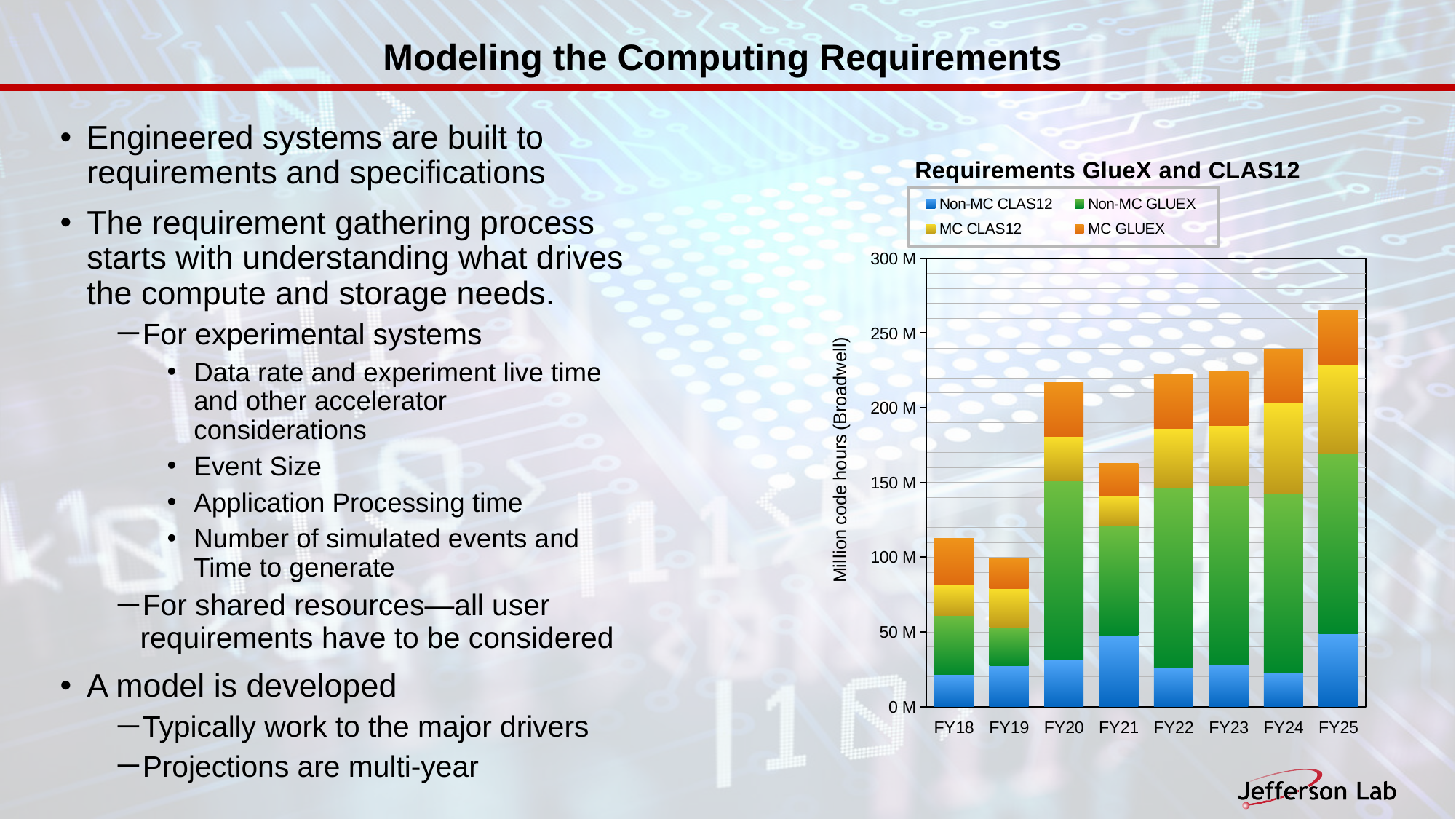
What is the label of the vertical axis of the chart? Million code hours (Broadwell) Is the total for FY21 greater or less than 150 M? greater Which fiscal year has the lowest total stacked bar? FY19 How many series does the chart legend list? 4 Is the total for FY25 greater or less than 250 M? greater What is the title of the chart? Requirements GlueX and CLAS12 Is the total for FY24 greater or less than 250 M? less Which fiscal year has the highest total stacked bar? FY25 What kind of chart is shown on the slide? Stacked bar chart How many fiscal years are shown on the x axis of the chart? 8 Which has the larger total stacked bar, FY18 or FY25? FY25 Do the total stacked bar values rise or fall from FY22 to FY25? rise